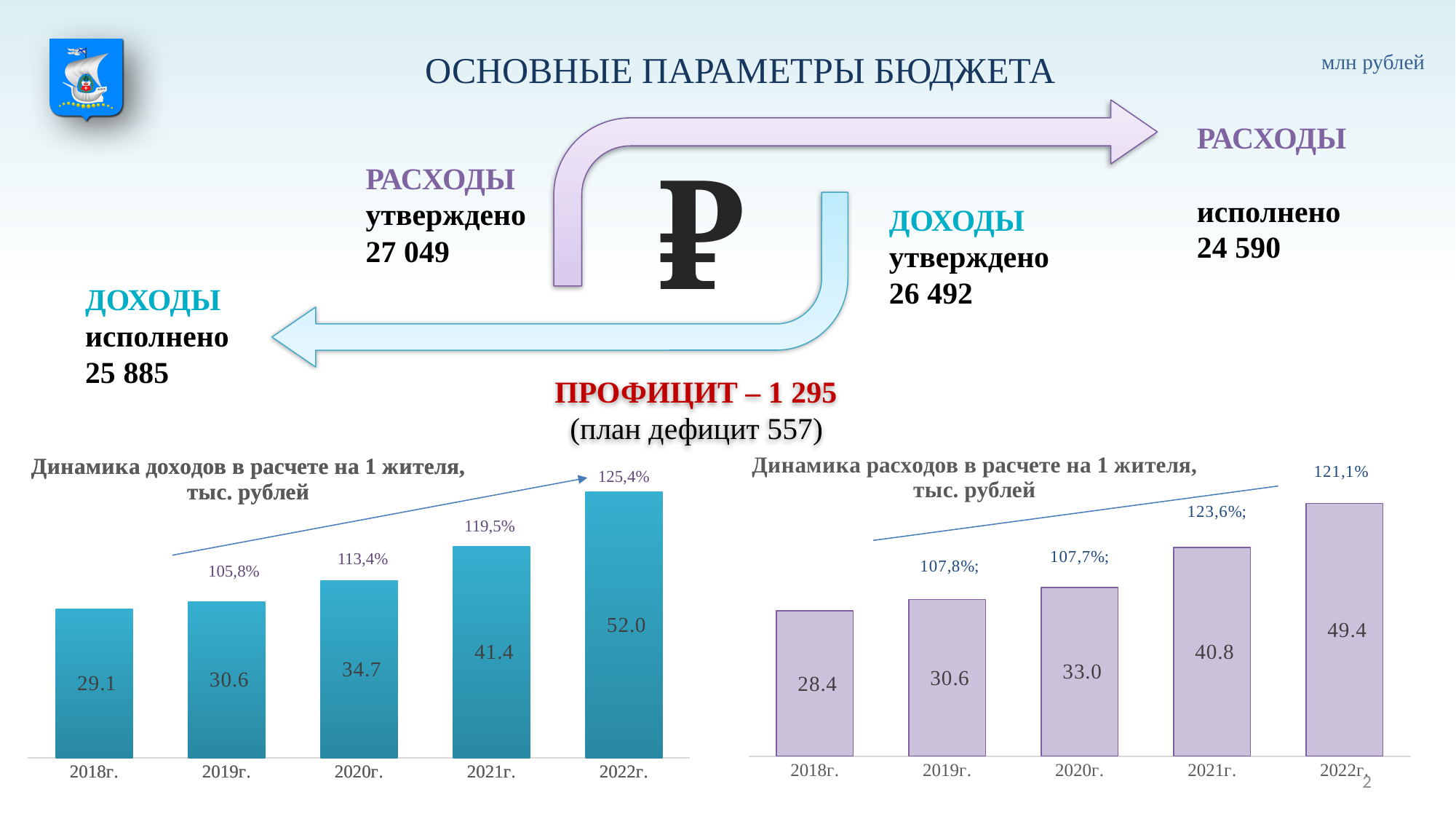
In the chart 'Динамика доходов в расчете на 1 жителя, тыс. рублей', what is the value for 2020г.? 34.7 In the chart 'Динамика расходов в расчете на 1 жителя, тыс. рублей', what percentage label is shown above the 2021г. bar? 123,6% In the chart 'Динамика доходов в расчете на 1 жителя, тыс. рублей', which year has the highest value? 2022г. How many years are shown in the chart 'Динамика расходов в расчете на 1 жителя, тыс. рублей'? 5 In the chart 'Динамика расходов в расчете на 1 жителя, тыс. рублей', what is the difference between the values for 2022г. and 2021г.? 8.6 What type of chart is 'Динамика доходов в расчете на 1 жителя, тыс. рублей'? Bar chart In the chart 'Динамика расходов в расчете на 1 жителя, тыс. рублей', what is the value for 2021г.? 40.8 In the chart 'Динамика доходов в расчете на 1 жителя, тыс. рублей', what percentage label is shown above the 2022г. bar? 125,4% Which is larger: the 2022г. value in the chart 'Динамика доходов в расчете на 1 жителя' or the 2022г. value in the chart 'Динамика расходов в расчете на 1 жителя'? Динамика доходов (52.0) In the chart 'Динамика расходов в расчете на 1 жителя, тыс. рублей', which year has the lowest value? 2018г. In the chart 'Динамика расходов в расчете на 1 жителя, тыс. рублей', do the values rise or fall from 2018г. to 2022г.? Rise In the chart 'Динамика доходов в расчете на 1 жителя, тыс. рублей', what is the difference between the values for 2022г. and 2018г.? 22.9